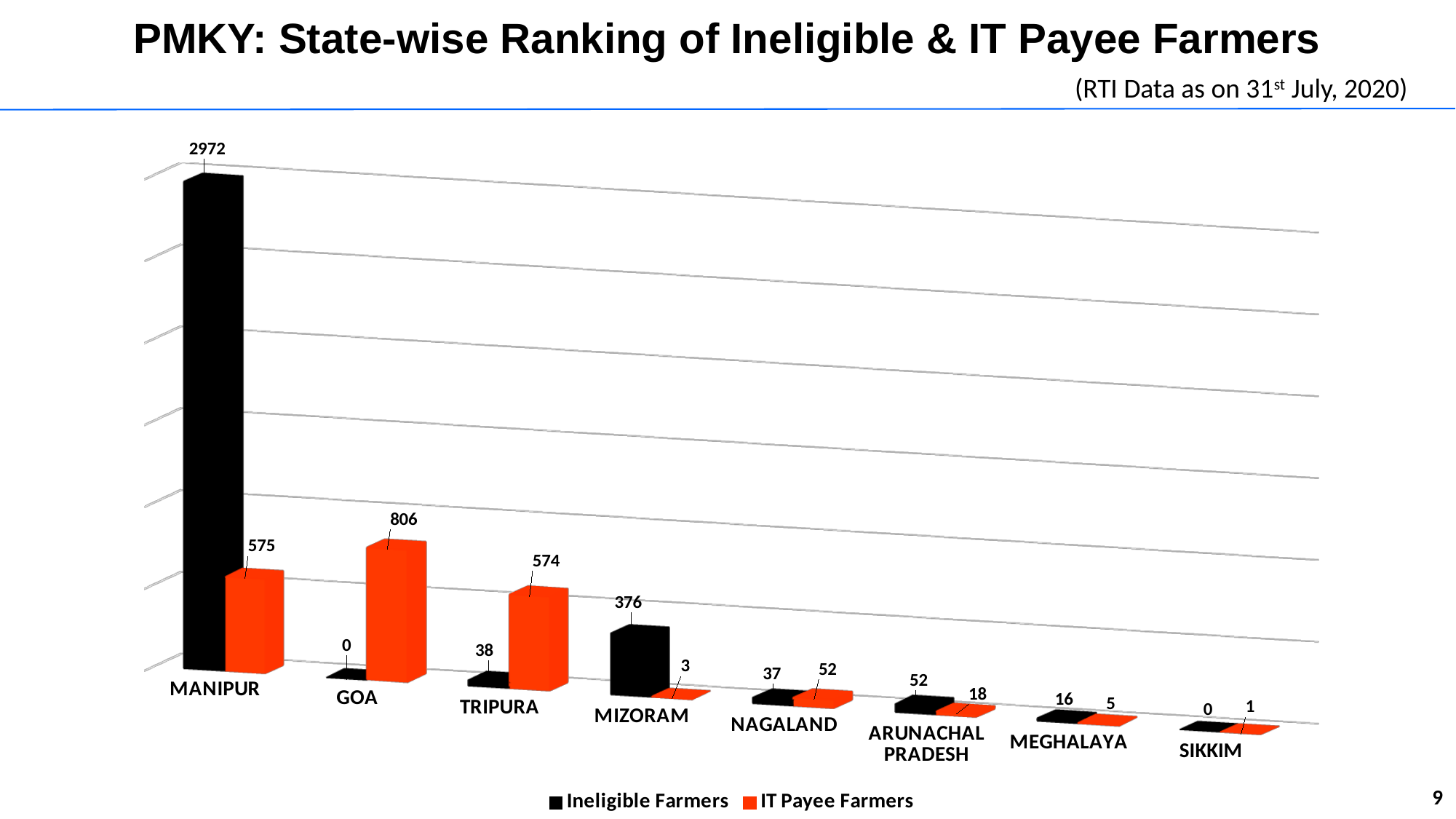
Which state has the highest value for Ineligible Farmers? Manipur What is the value for Ineligible Farmers in Mizoram? 376 What is the difference between Ineligible Farmers and IT Payee Farmers in Manipur? 2397 What is the value for IT Payee Farmers in Tripura? 574 What kind of chart is shown on the slide? Bar chart What is the value for Ineligible Farmers in Manipur? 2972 Which is larger in Nagaland: Ineligible Farmers or IT Payee Farmers? IT Payee Farmers How many series does the legend list? 2 How many states are shown on the chart? 8 What is the value for IT Payee Farmers in Goa? 806 Which colour represents IT Payee Farmers in the chart? Orange Which state has the highest value for IT Payee Farmers? Goa